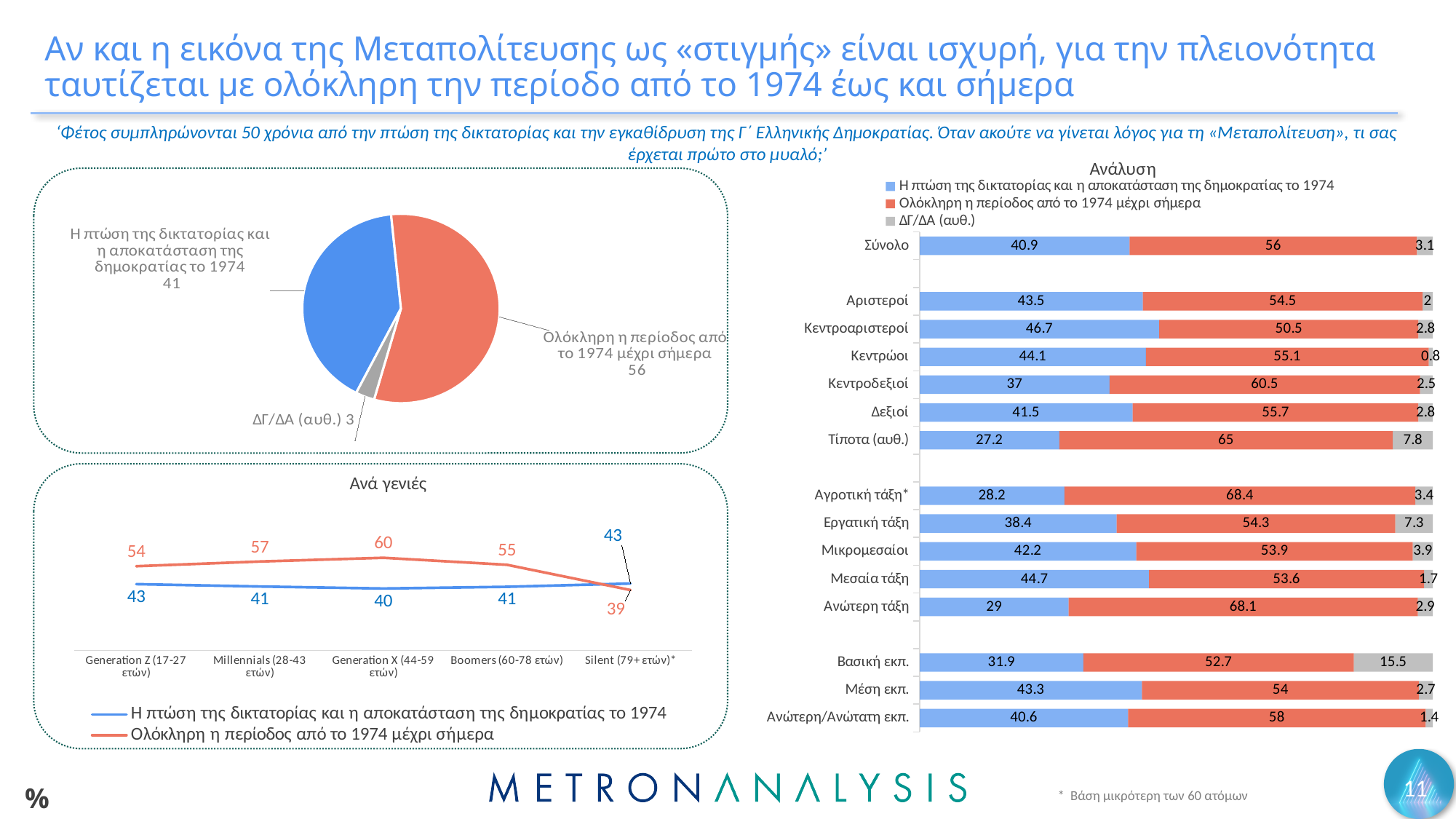
In the 'Ανάλυση' chart on the right, how many series does the legend list? 3 In the 'Ανά γενιές' chart, which series has the higher value for Silent (79+ ετών)? Η πτώση της δικτατορίας και η αποκατάσταση της δημοκρατίας το 1974 In the 'Ανά γενιές' chart, how many generation categories are shown on the x axis? 5 In the pie chart on the top left, what value is shown for the slice 'Ολόκληρη η περίοδος από το 1974 μέχρι σήμερα'? 56 In the 'Ανάλυση' chart on the right, what is the difference between the 'Η πτώση της δικτατορίας και η αποκατάσταση της δημοκρατίας το 1974' values for Κεντροαριστεροί and Κεντροδεξιοί? 9.7 In the 'Ανά γενιές' chart, what is the value of 'Ολόκληρη η περίοδος από το 1974 μέχρι σήμερα' for Generation X (44-59 ετών)? 60 In the 'Ανάλυση' chart on the right, which category has the highest value for 'ΔΓ/ΔΑ (αυθ.)'? Βασική εκπ. In the 'Ανάλυση' chart on the right, what is the value of 'Ολόκληρη η περίοδος από το 1974 μέχρι σήμερα' for Αγροτική τάξη*? 68.4 In the 'Ανάλυση' chart on the right, which category has the lowest value for 'Η πτώση της δικτατορίας και η αποκατάσταση της δημοκρατίας το 1974'? Τίποτα (αυθ.) In the 'Ανά γενιές' chart, what is the difference between the two series for Boomers (60-78 ετών)? 14 In the pie chart on the top left, which slice is the smallest? ΔΓ/ΔΑ (αυθ.) What kind of chart is the 'Ανά γενιές' chart on the bottom left? Line chart